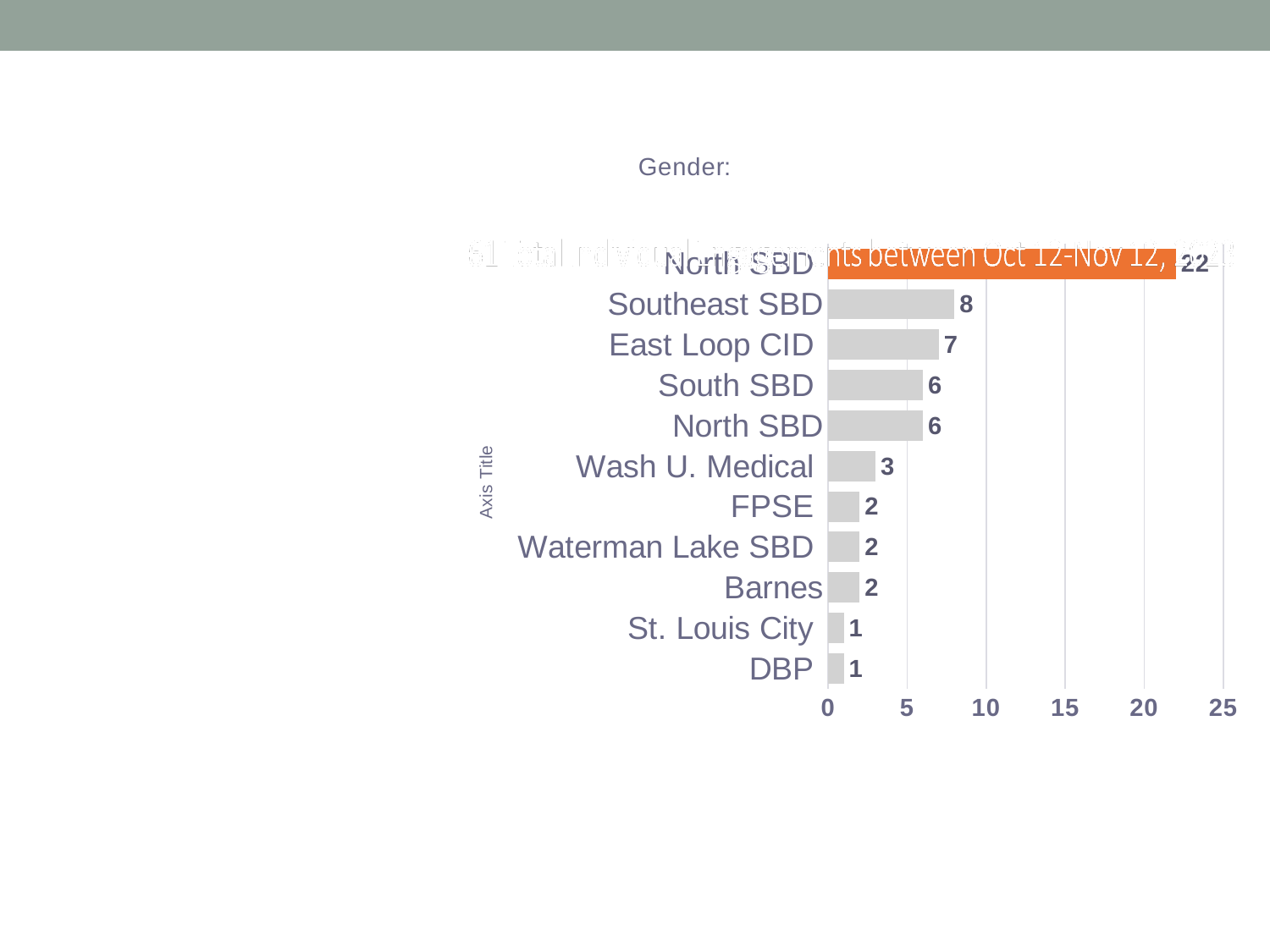
What kind of chart is shown on the slide? Bar chart What is the value for DBP? 1 What is the value for Wash U. Medical? 3 Which has a larger value, South SBD or Wash U. Medical? South SBD What is the highest value shown on the chart? 22 What is the lowest value shown on the chart? 1 How many categories (bars) are shown on the chart? 11 What is the value of the orange bar at the top of the chart? 22 What is the value for Southeast SBD? 8 What is the difference between the values for Southeast SBD and East Loop CID? 1 What colour is the longest bar on the chart? Orange What is the value for East Loop CID? 7